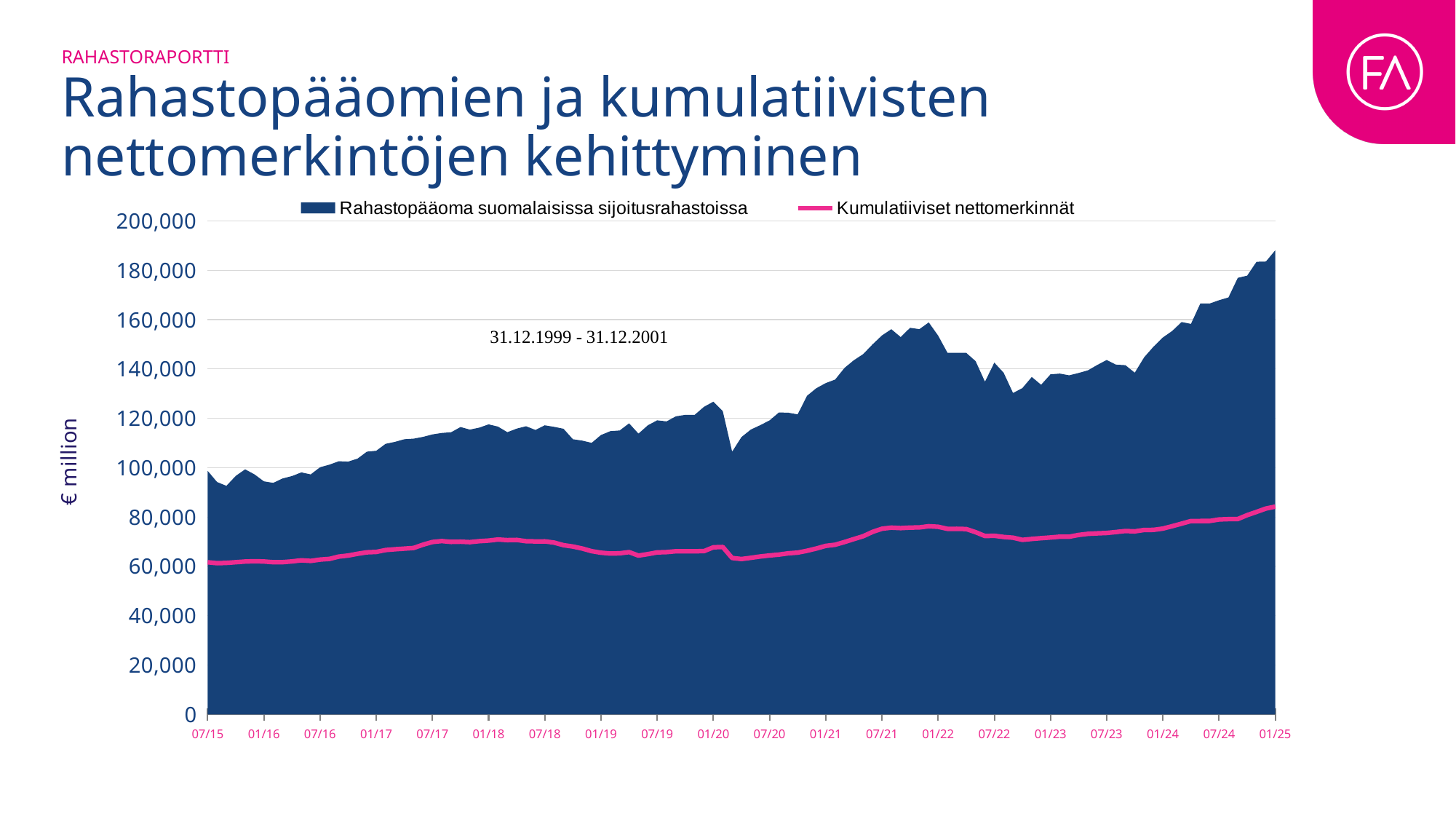
Is the value of Rahastopääoma suomalaisissa sijoitusrahastoissa at 01/25 greater or less than 160,000? greater At 01/25, which series has the higher value: Rahastopääoma suomalaisissa sijoitusrahastoissa or Kumulatiiviset nettomerkinnät? Rahastopääoma suomalaisissa sijoitusrahastoissa What unit is shown on the y-axis label? € million How many series does the legend list? 2 How many date labels are shown along the x axis? 20 Overall, does Rahastopääoma suomalaisissa sijoitusrahastoissa rise or fall from 07/15 to 01/25? rise What kind of chart is shown on the slide? area chart with a line Is the value of Kumulatiiviset nettomerkinnät at 01/25 greater or less than 80,000? greater Is the value of Rahastopääoma suomalaisissa sijoitusrahastoissa at 07/21 greater or less than 140,000? greater At which x-axis label does Rahastopääoma suomalaisissa sijoitusrahastoissa reach its highest value? 01/25